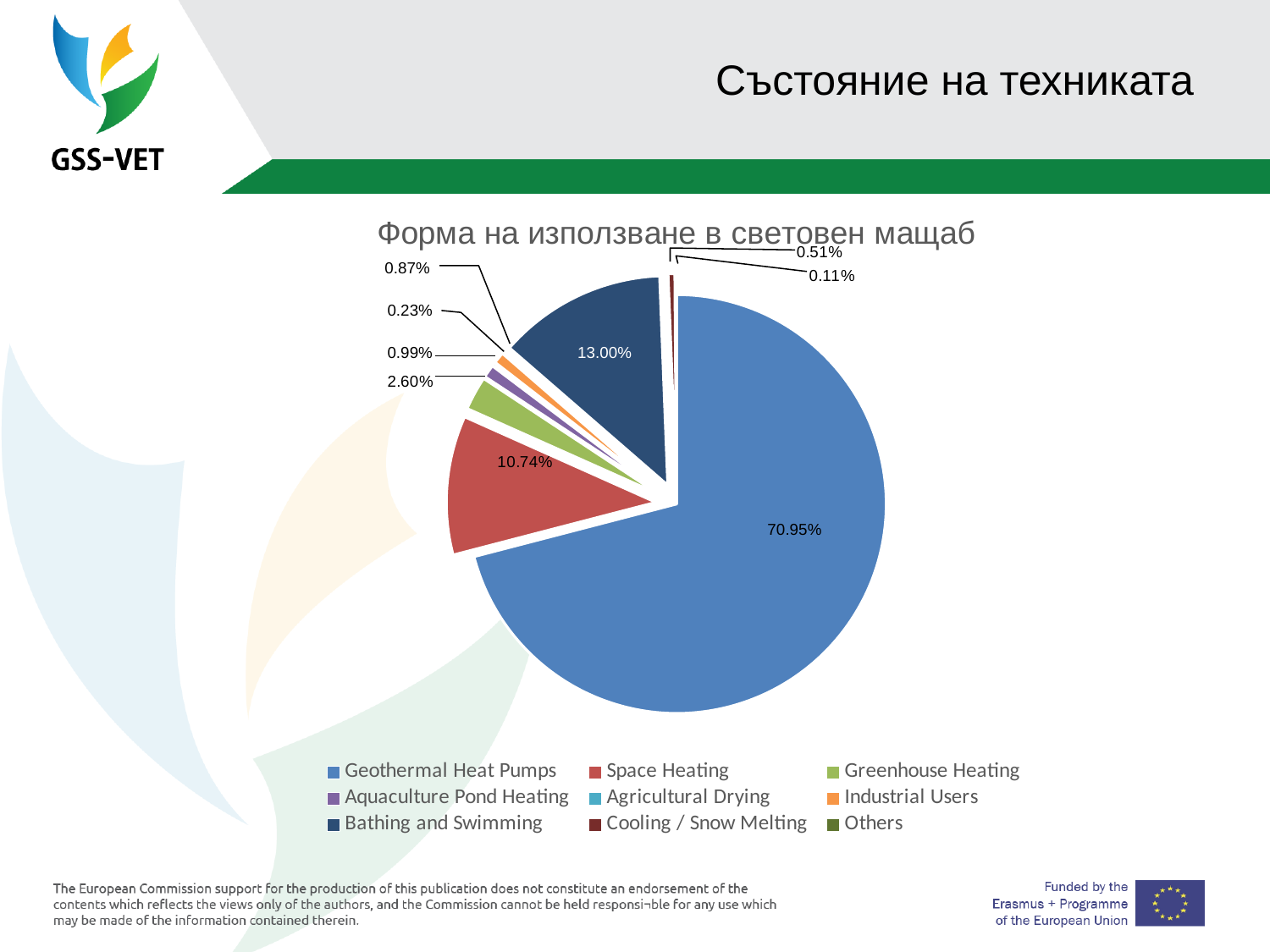
How many categories does the legend list? 9 What is the difference between the Bathing and Swimming share and the Space Heating share? 2.26% What share of the pie does Geothermal Heat Pumps have? 70.95% Which category has the largest slice of the pie? Geothermal Heat Pumps What is the value shown for Bathing and Swimming? 13.00% Which is larger, the share for Bathing and Swimming or the share for Space Heating? Bathing and Swimming What is the difference between the Geothermal Heat Pumps share and the Bathing and Swimming share? 57.95% What is the value shown for Space Heating? 10.74% What is the value shown for Greenhouse Heating? 2.60% What is the title of the chart? Форма на използване в световен мащаб What type of chart is shown on the slide? pie chart Which category has the smallest slice of the pie? Others